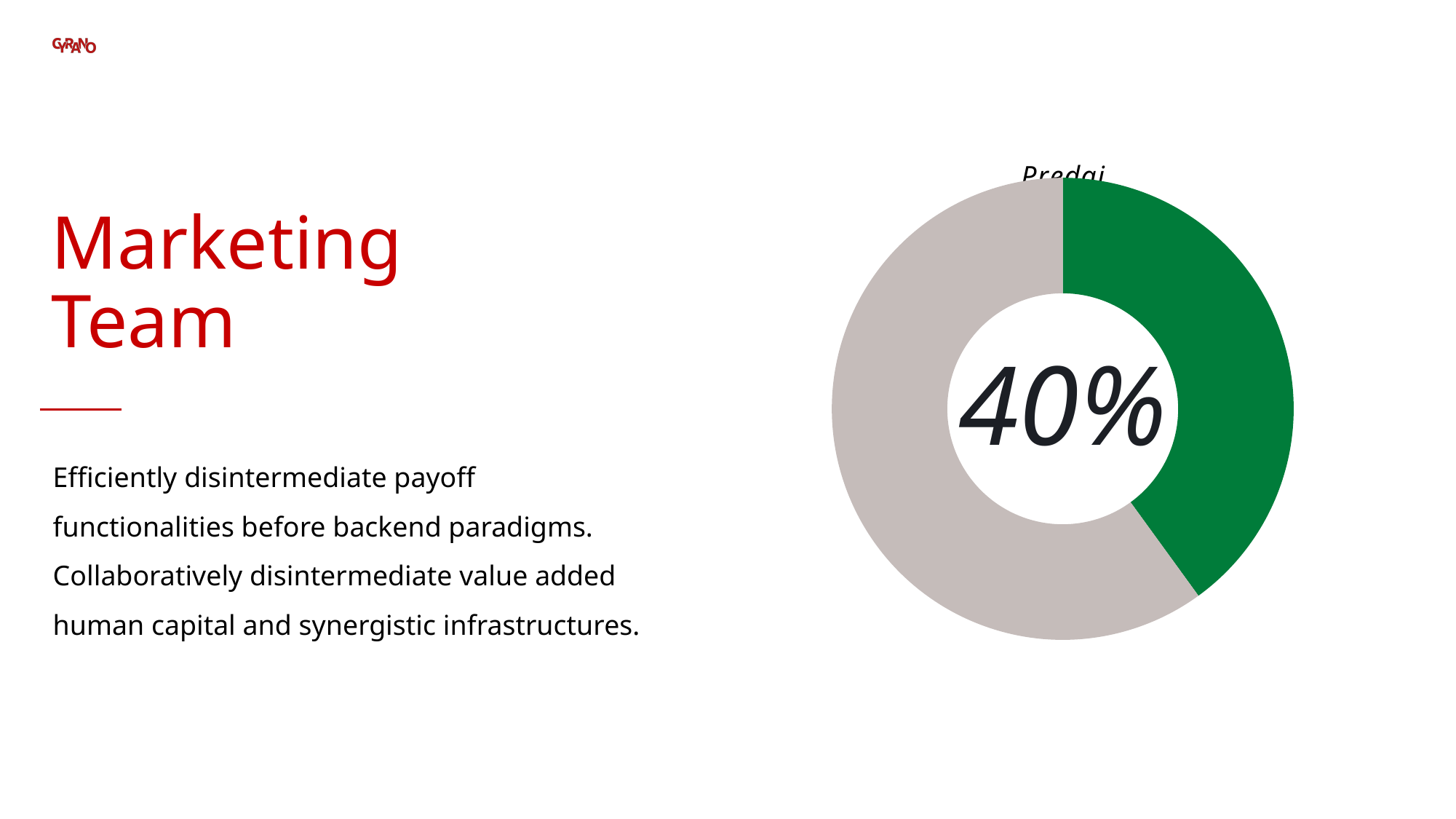
Which slice of the doughnut chart is the smallest? The green slice What percentage is printed in the centre of the doughnut chart? 40% What kind of chart is shown on the slide? Doughnut chart What share of the doughnut chart does the green slice represent? 40% What is the title shown above the doughnut chart? Predaj How many slices does the doughnut chart have? 2 Which slice of the doughnut chart is larger, the green one or the grey one? The grey one What colour is the slice labelled 40% in the doughnut chart? Green